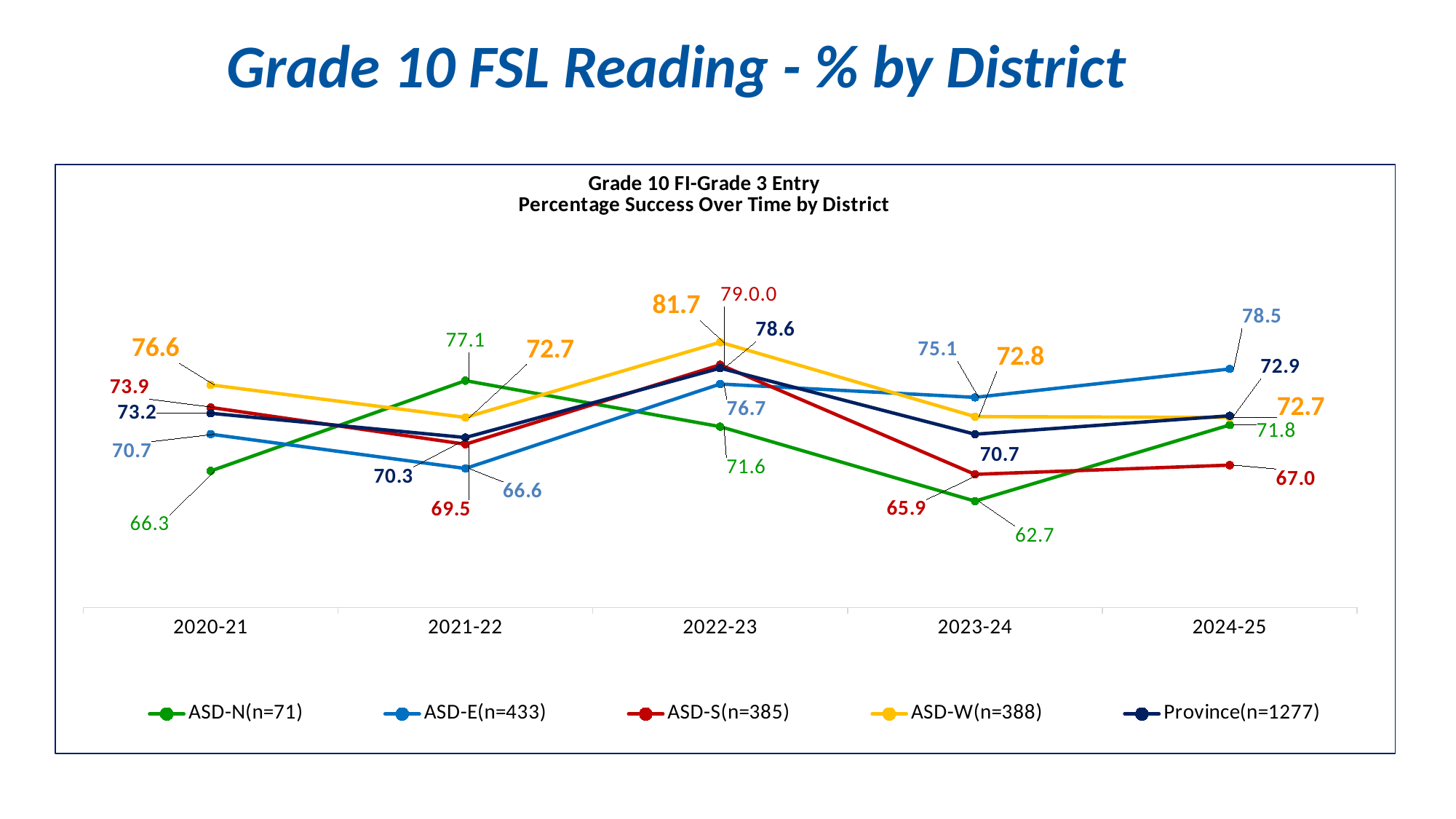
How many series does the legend list? 5 Which series has the lowest value in 2020-21? ASD-N(n=71) Which series has the highest value in 2024-25? ASD-E(n=433) How many school years are shown along the x axis? 5 In 2021-22, which is larger: the value for ASD-N(n=71) or the value for ASD-S(n=385)? ASD-N(n=71) By how much did the value for ASD-E(n=433) change from 2023-24 to 2024-25? 3.4 What is the value for ASD-N(n=71) in 2023-24? 62.7 Does the value for ASD-E(n=433) rise or fall from 2021-22 to 2024-25? Rise What is the value for ASD-W(n=388) in 2022-23? 81.7 What kind of chart is shown on the slide? Line chart What is the value for Province(n=1277) in 2022-23? 78.6 What is the title printed inside the chart area? Grade 10 FI-Grade 3 Entry Percentage Success Over Time by District